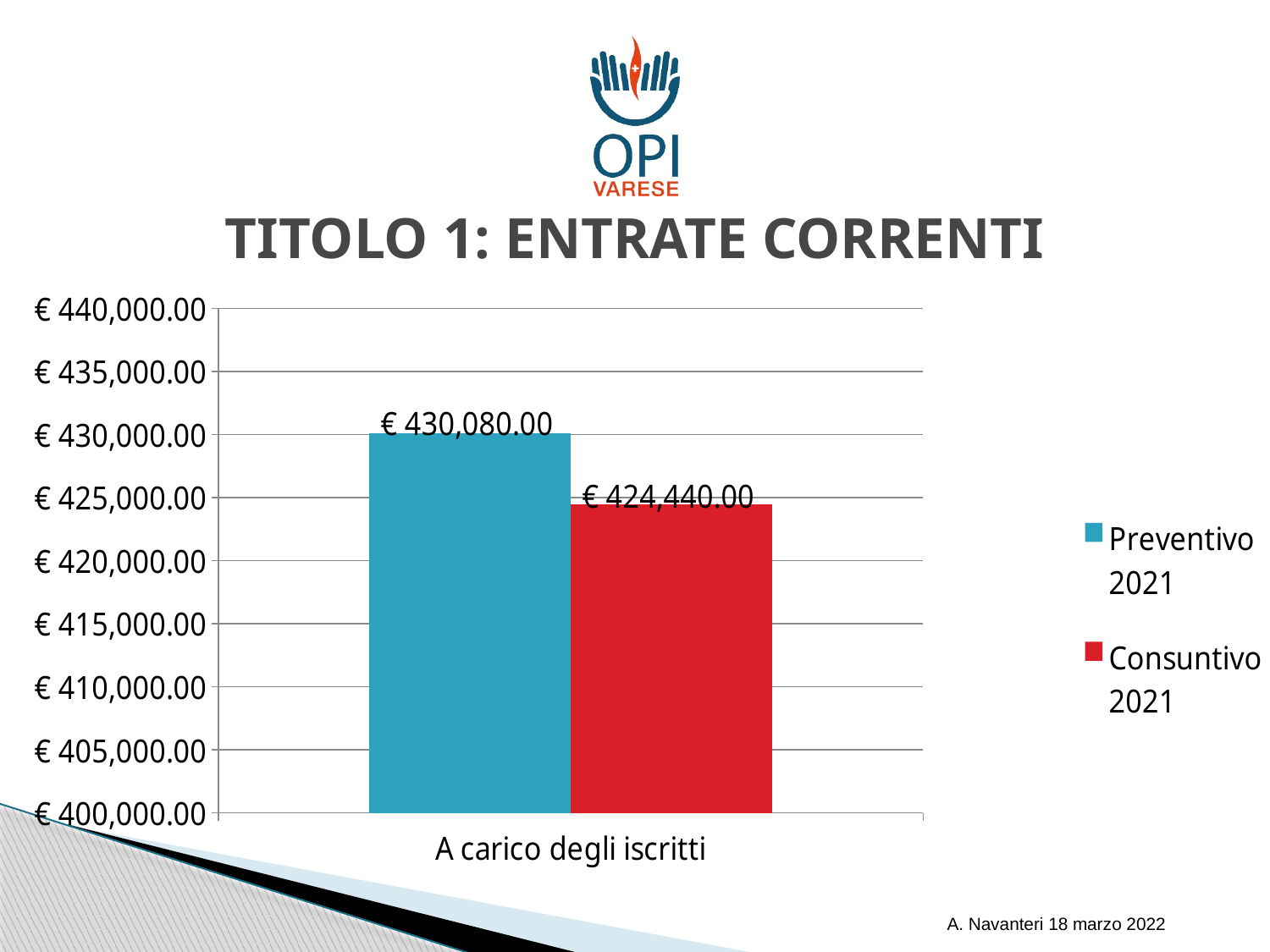
What is the value of Preventivo 2021 for A carico degli iscritti? € 430,080.00 Is the value for Consuntivo 2021 greater or less than € 425,000.00? less What colour is the bar for Consuntivo 2021? red How many series does the legend list? 2 Which series has the higher value for A carico degli iscritti, Preventivo 2021 or Consuntivo 2021? Preventivo 2021 What is the label of the category on the x axis? A carico degli iscritti Is the value for Preventivo 2021 greater or less than € 430,000.00? greater How many categories are shown on the x axis? 1 What is the difference between Preventivo 2021 and Consuntivo 2021 for A carico degli iscritti? € 5,640.00 What kind of chart is shown on the slide? bar chart What is the title of the slide above the chart? TITOLO 1: ENTRATE CORRENTI What is the value of Consuntivo 2021 for A carico degli iscritti? € 424,440.00